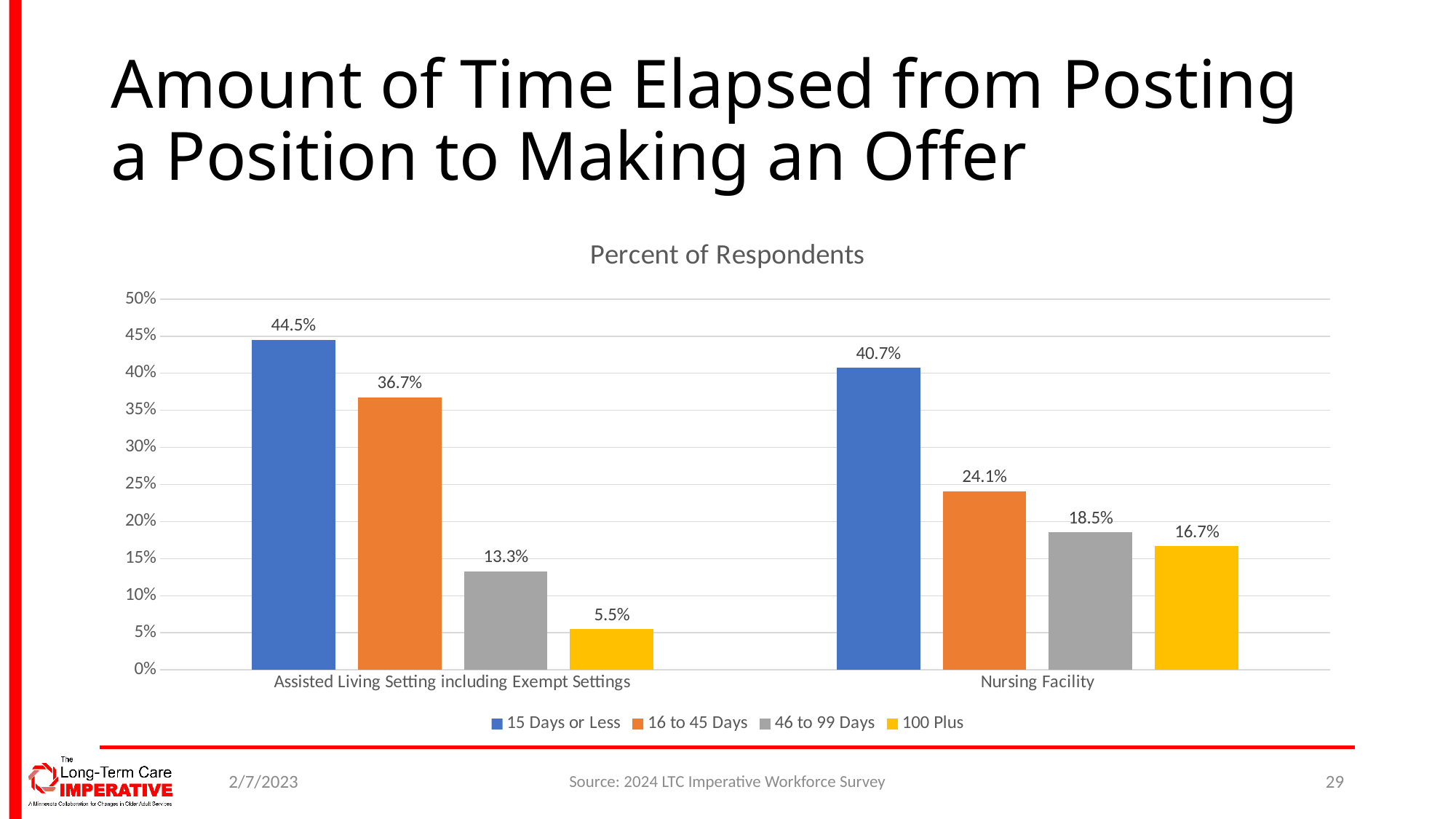
What is the value for 100 Plus in the Nursing Facility category? 16.7% Which is larger: the 100 Plus value for Nursing Facility or the 46 to 99 Days value for Assisted Living Setting including Exempt Settings? 100 Plus value for Nursing Facility Is the 16 to 45 Days value for Nursing Facility greater or less than 25%? less What percent of respondents in the Assisted Living Setting including Exempt Settings reported 15 Days or Less? 44.5% Which series has the highest value for Nursing Facility? 15 Days or Less What kind of chart is shown on the slide? Bar chart What is the value for 46 to 99 Days in the Assisted Living Setting including Exempt Settings category? 13.3% Which series has the lowest value for Assisted Living Setting including Exempt Settings? 100 Plus How many categories are shown on the x axis? 2 What is the difference between the 16 to 45 Days values for Assisted Living Setting including Exempt Settings and Nursing Facility? 12.6% How many series does the legend list? 4 What is the title of the chart? Percent of Respondents